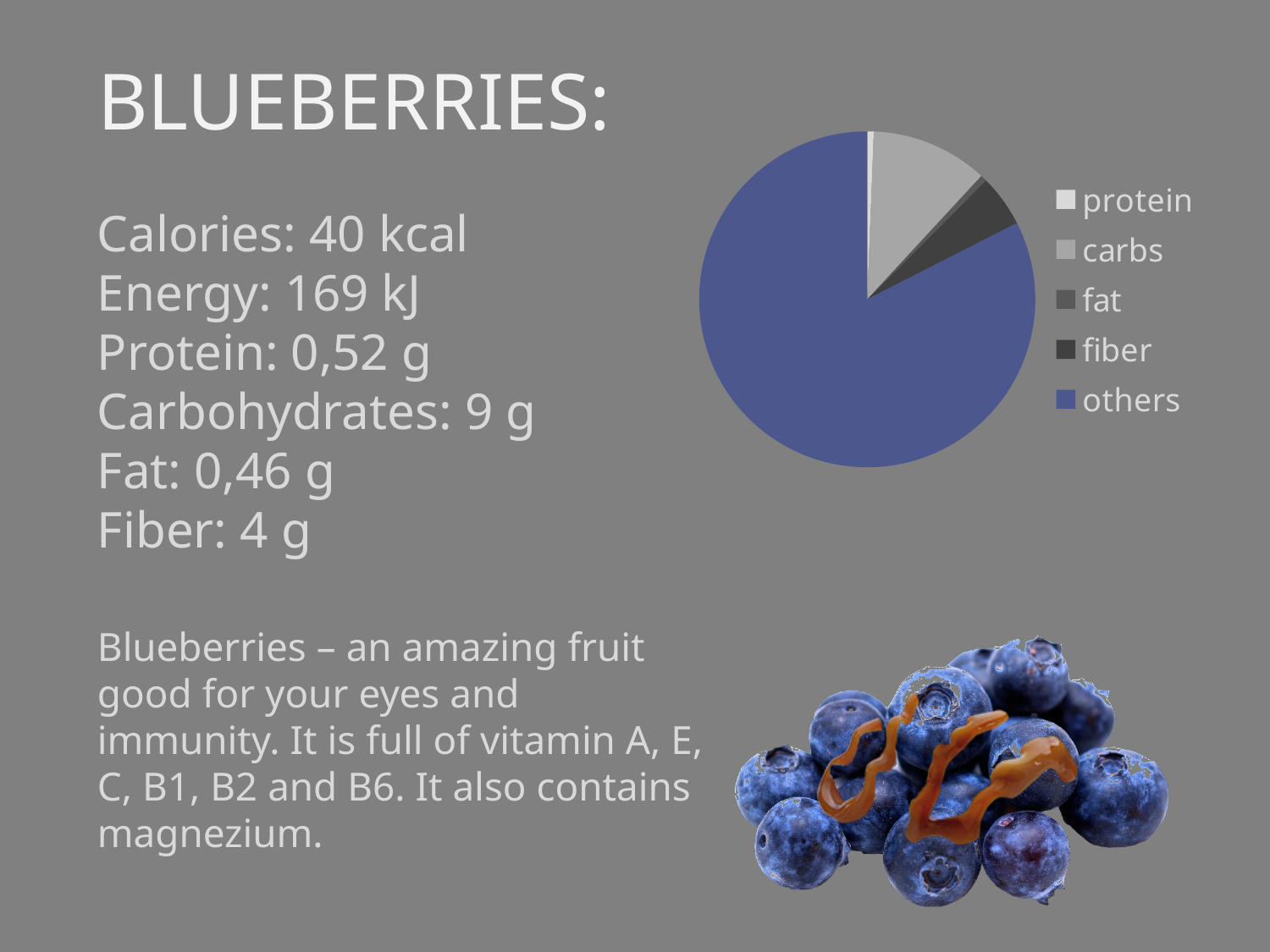
What kind of chart is shown on the slide? pie chart Which slice is larger in the pie chart, others or carbs? others How many entries does the legend of the pie chart list? 5 How many categories does the pie chart show? 5 Which category has the largest slice in the pie chart? others Which category is listed first in the pie chart's legend? protein What colour is the 'others' slice in the pie chart? blue Does the 'others' slice take up more or less than half of the pie chart? more Which slice is larger in the pie chart, fiber or fat? fiber Which slice is larger in the pie chart, carbs or fiber? carbs